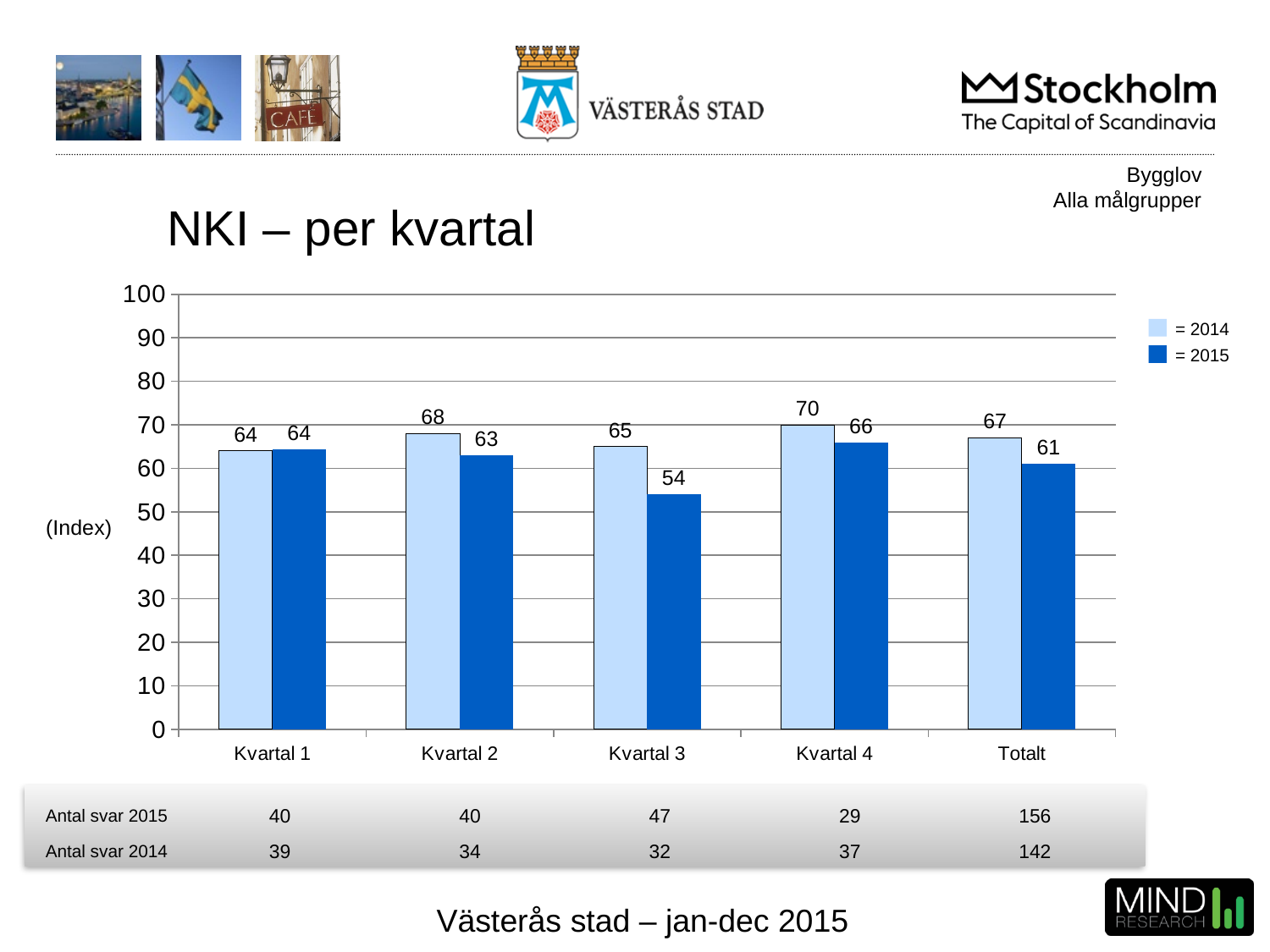
Is the 2015 value for Kvartal 4 greater or less than 60? greater What is the difference between the 2014 and 2015 values for Kvartal 3? 11 What is the 2015 value for Totalt? 61 Which category has the lowest 2015 value? Kvartal 3 Which is larger for Kvartal 2, the 2014 value or the 2015 value? 2014 Which category has the highest 2014 value? Kvartal 4 How many categories are shown on the x axis? 5 What is the 2015 value for Kvartal 3? 54 What is the title of the chart? NKI – per kvartal What kind of chart is shown on the slide? bar chart How many series does the legend list? 2 What is the 2014 value for Kvartal 4? 70